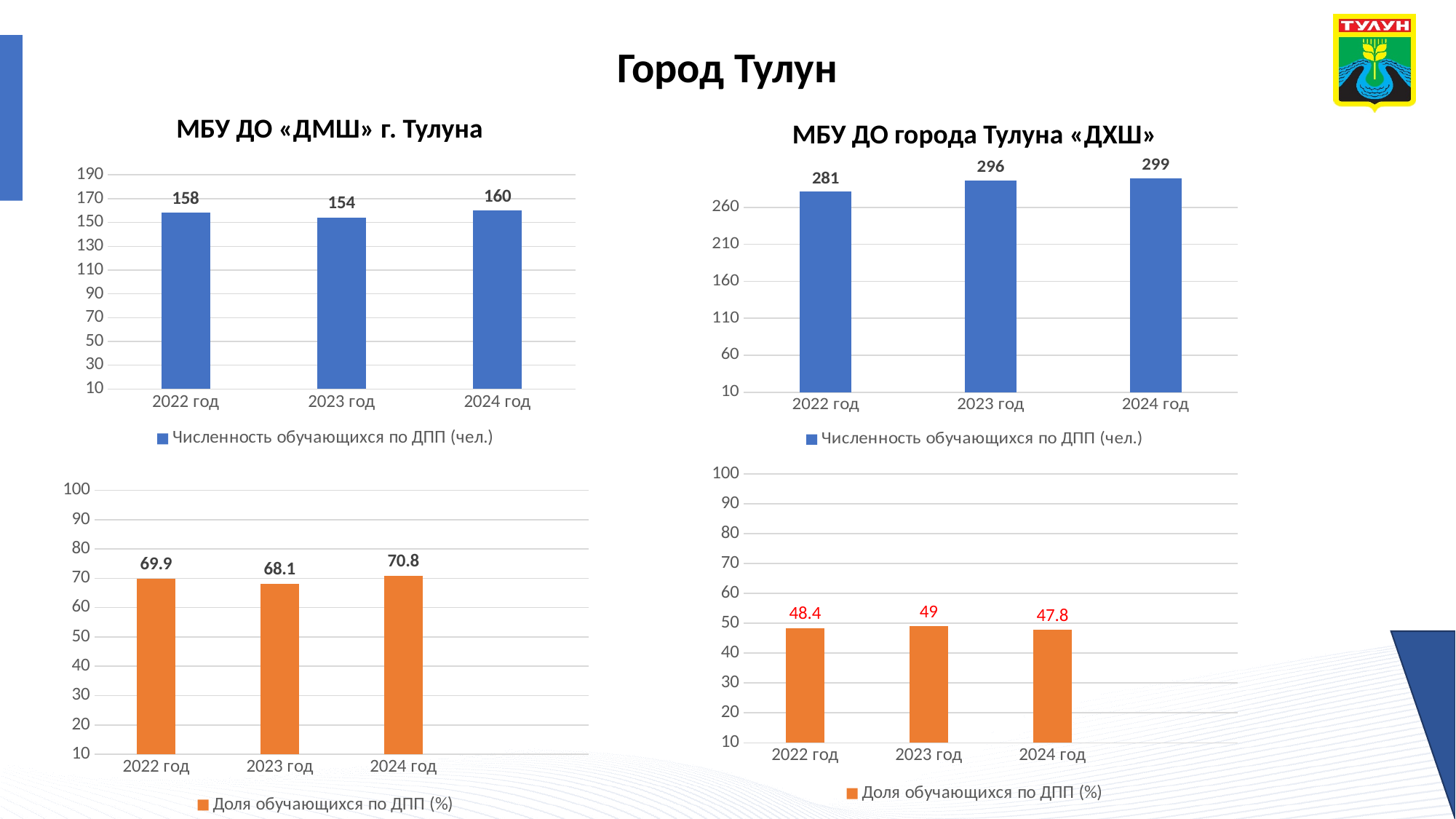
In the top-left chart (МБУ ДО «ДМШ» г. Тулуна, численность обучающихся), which year has the highest value? 2024 год In the bottom-right chart (ДХШ, доля обучающихся по ДПП %), what is the value for 2023 год? 49 What type of chart is the bottom-right chart (ДХШ, доля обучающихся по ДПП %)? bar chart In the bottom-right chart (ДХШ, доля обучающихся по ДПП %), is the value for 2022 год larger or smaller than the value for 2024 год? larger In the top-right chart (МБУ ДО города Тулуна «ДХШ», численность обучающихся), which year has the lowest value? 2022 год In the top-right chart (МБУ ДО города Тулуна «ДХШ», численность обучающихся), what is the value for 2022 год? 281 In the top-left chart (МБУ ДО «ДМШ» г. Тулуна, численность обучающихся), what is the value for 2023 год? 154 In the bottom-left chart (ДМШ, доля обучающихся по ДПП %), which year has the lowest value? 2023 год How many categories (years) are shown on the x axis of the top-left chart (МБУ ДО «ДМШ» г. Тулуна)? 3 In the bottom-left chart (ДМШ, доля обучающихся по ДПП %), what is the value for 2024 год? 70.8 In the top-right chart (МБУ ДО города Тулуна «ДХШ», численность обучающихся), what is the difference between the 2023 год and 2022 год values? 15 In the top-left chart (МБУ ДО «ДМШ» г. Тулуна, численность обучающихся), what is the difference between the 2024 год and 2023 год values? 6